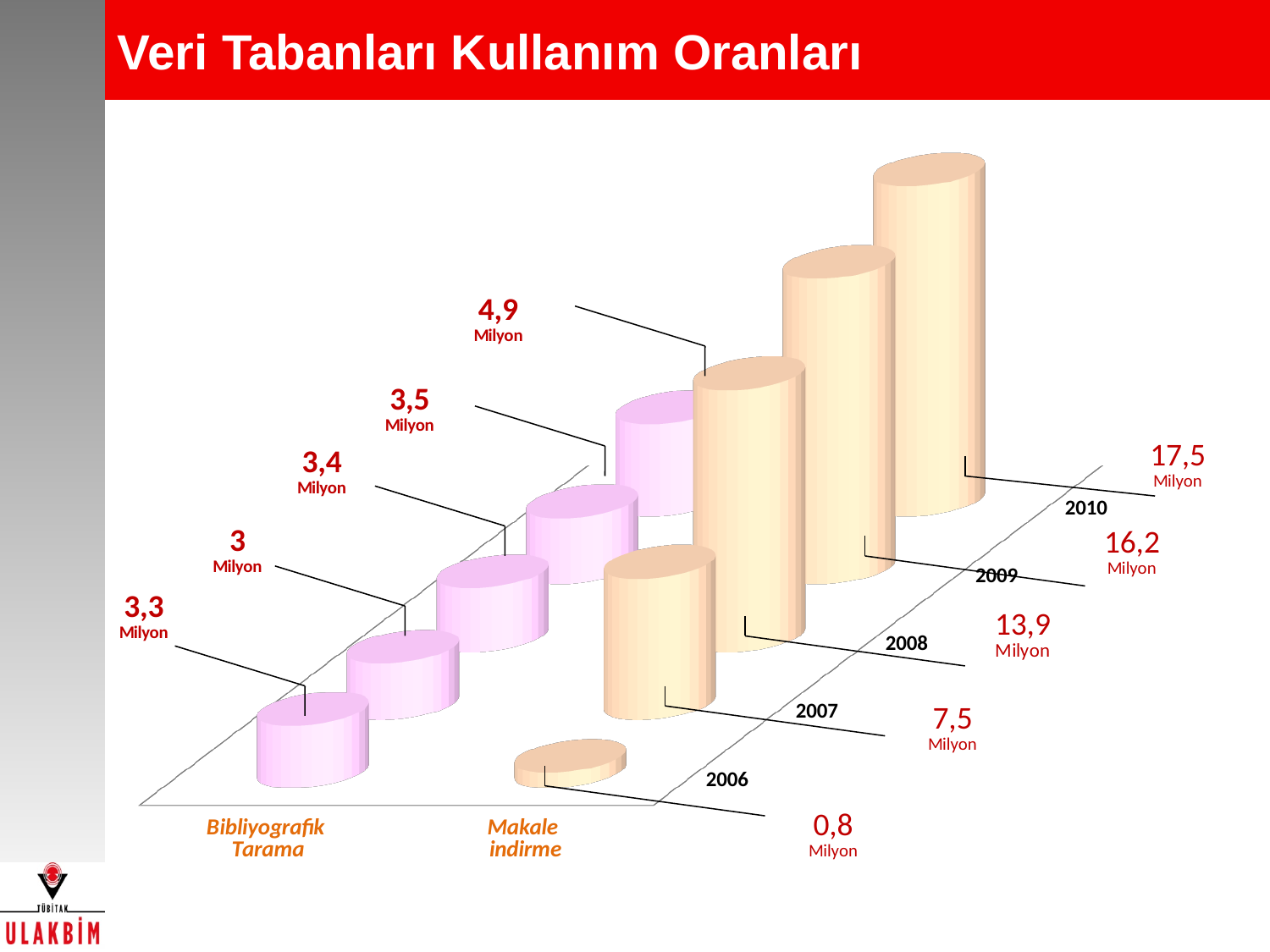
In which year is Makale indirme highest? 2010 What is the difference between Makale indirme in 2010 and in 2009? 1,3 Milyon In which year is Bibliyografik Tarama lowest? 2007 What is the value for Bibliyografik Tarama in 2006? 3,3 Milyon What is the value for Bibliyografik Tarama in 2010? 4,9 Milyon Does Makale indirme rise or fall from 2006 to 2010? Rise Which is larger in 2008: Makale indirme or Bibliyografik Tarama? Makale indirme What kind of chart is shown on the slide? Bar chart What is the value for Makale indirme in 2010? 17,5 Milyon What is the value for Makale indirme in 2006? 0,8 Milyon How many years are shown on the chart? 5